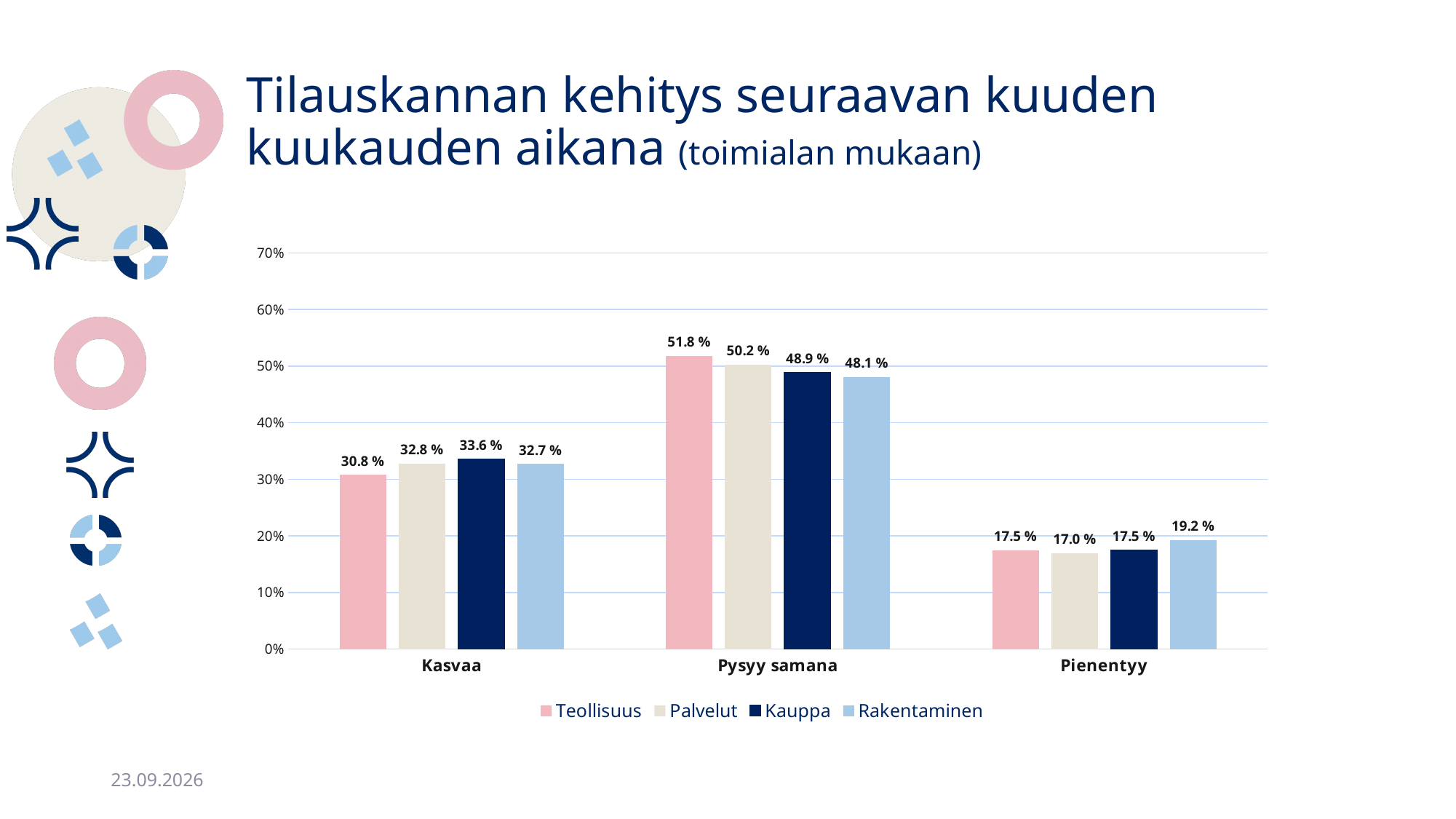
What kind of chart is shown on the slide? bar chart What is the value for Teollisuus in the Kasvaa category? 30.8 % Which series has the highest value in the Pysyy samana category? Teollisuus What is the value for Rakentaminen in the Pienentyy category? 19.2 % What is the value for Kauppa in the Pysyy samana category? 48.9 % What is the difference between Teollisuus and Rakentaminen in the Pysyy samana category? 3.7 % Which series has the lowest value in the Kasvaa category? Teollisuus Is the value for Palvelut in the Pysyy samana category greater or less than 40%? greater How many series does the legend list? 4 Which is larger: Kauppa in Kasvaa or Palvelut in Kasvaa? Kauppa in Kasvaa Which colour represents the Kauppa series in the legend? dark navy blue How many categories are shown on the x axis? 3